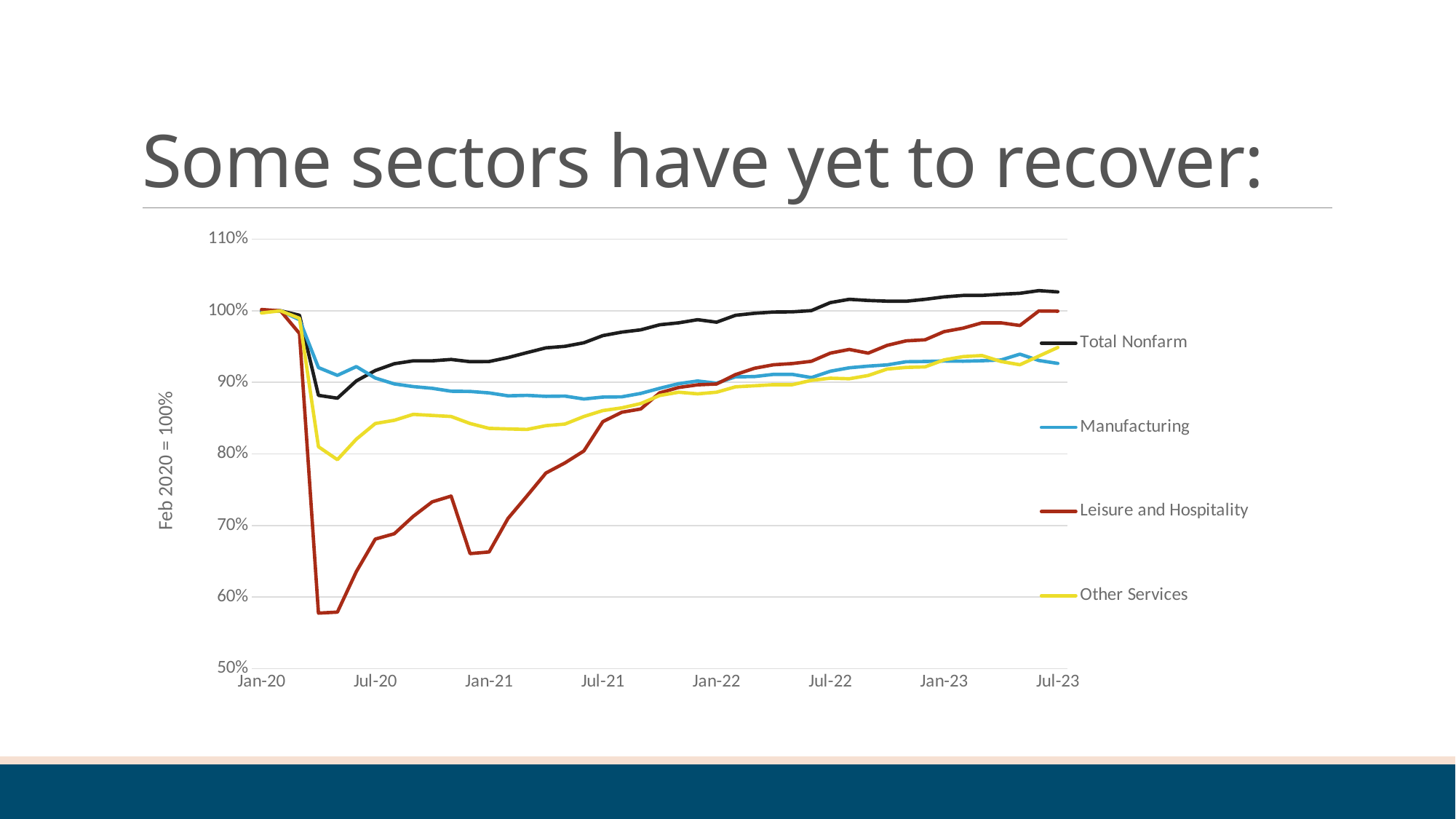
What is the label on the vertical axis? Feb 2020 = 100% What kind of chart is shown on the slide? line chart How many series does the legend list? 4 Which series has the highest value at Jul-23? Total Nonfarm From Jan-21 to Jul-23, does the Leisure and Hospitality line generally rise or fall? rise At Jan-21, which is larger: Manufacturing or Leisure and Hospitality? Manufacturing Is the lowest value for Other Services in 2020 greater or less than 70%? greater What is the title of the slide? Some sectors have yet to recover: Is the value for Total Nonfarm at Jul-23 greater or less than 100%? greater Is the value for Manufacturing at Jul-23 greater or less than 100%? less Which series falls to the lowest value during 2020? Leisure and Hospitality